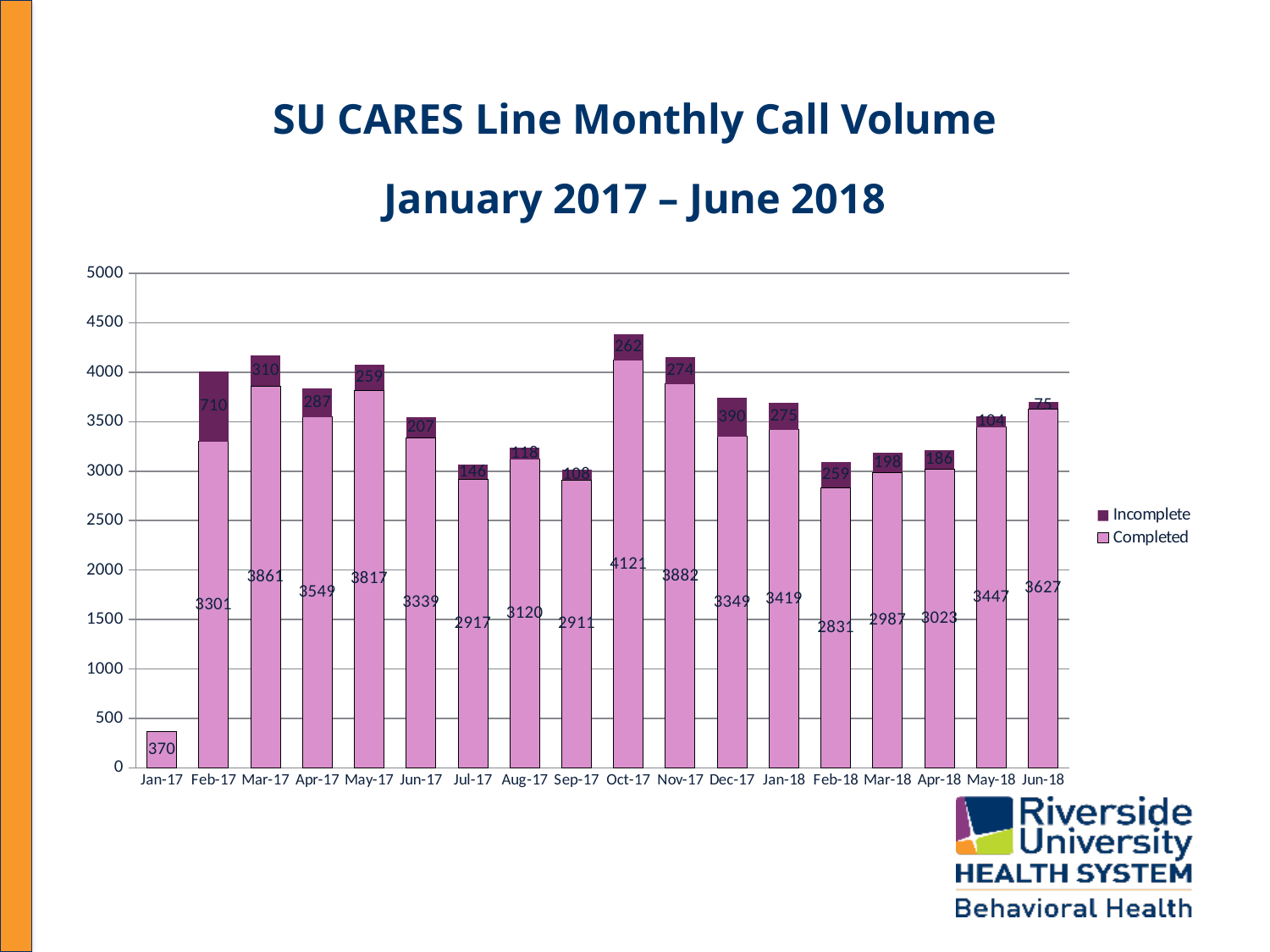
Which month has the lowest Completed value? Jan-17 Which is larger, the Completed value for Nov-17 or for Mar-17? Nov-17 What is the Completed value for Feb-18? 2831 How many series does the legend list? 2 What is the difference between the Completed values for Oct-17 and Sep-17? 1210 Which month has the highest Incomplete value? Feb-17 Which month has the highest Completed value? Oct-17 What is the total of the stacked bar for Feb-17? 4011 How many months are shown on the x axis? 18 What is the Completed value for Oct-17? 4121 What kind of chart is shown on the slide? Stacked bar chart What is the Incomplete value for Feb-17? 710